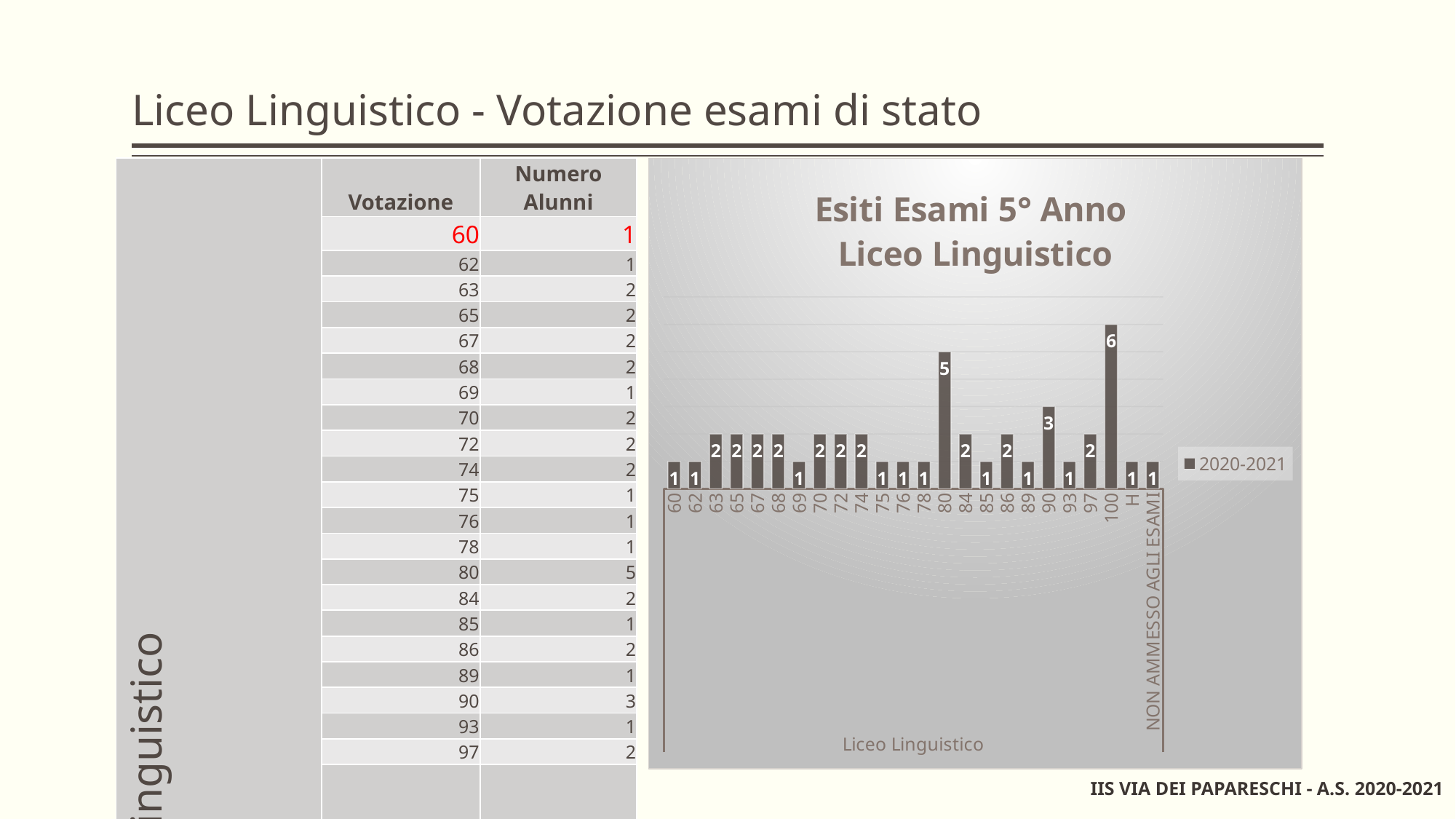
What is the value for the 80 category in the chart? 5 How many categories are shown on the x axis of the chart? 24 Which is larger in the chart, the value for 90 or the value for 97? 90 What is the difference between the values for 80 and 90 in the chart? 2 What is the value for the NON AMMESSO AGLI ESAMI category in the chart? 1 What is the title of the chart? Esiti Esami 5° Anno Liceo Linguistico What is the value for the 90 category in the chart? 3 Which category has the highest value in the chart? 100 What kind of chart is shown on the slide? bar chart What is the value for the 100 category in the chart? 6 How many series does the chart legend list? 1 What is the difference between the values for 100 and 80 in the chart? 1